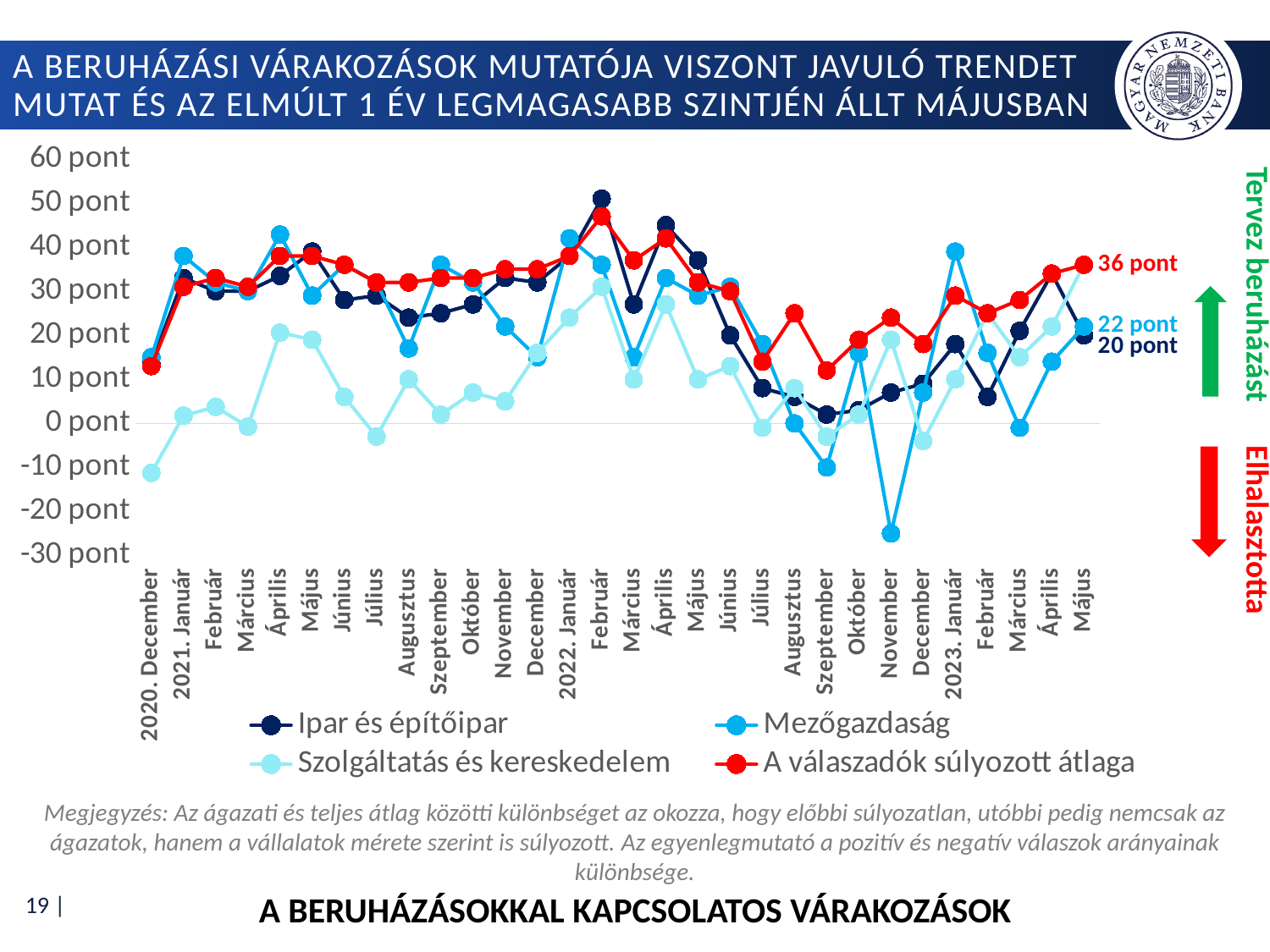
What kind of chart is shown on the slide? line chart In 2023 Május, which is larger: 'Mezőgazdaság' or 'Ipar és építőipar'? Mezőgazdaság What is the value of 'Ipar és építőipar' in 2023 Május? 20 pont Is the value for 'Szolgáltatás és kereskedelem' in 2020. December greater or less than 0 pont? less Is the value for 'Ipar és építőipar' in 2022 Február greater or less than 40 pont? greater Is the value for 'Mezőgazdaság' in 2022 November greater or less than -20 pont? less What is the value of 'Mezőgazdaság' in 2023 Május? 22 pont How many series does the legend list? 4 How many months (categories) are plotted on the x axis? 30 What is the value of 'A válaszadók súlyozott átlaga' in 2023 Május? 36 pont What is the difference between 'A válaszadók súlyozott átlaga' and 'Ipar és építőipar' in 2023 Május? 16 pont